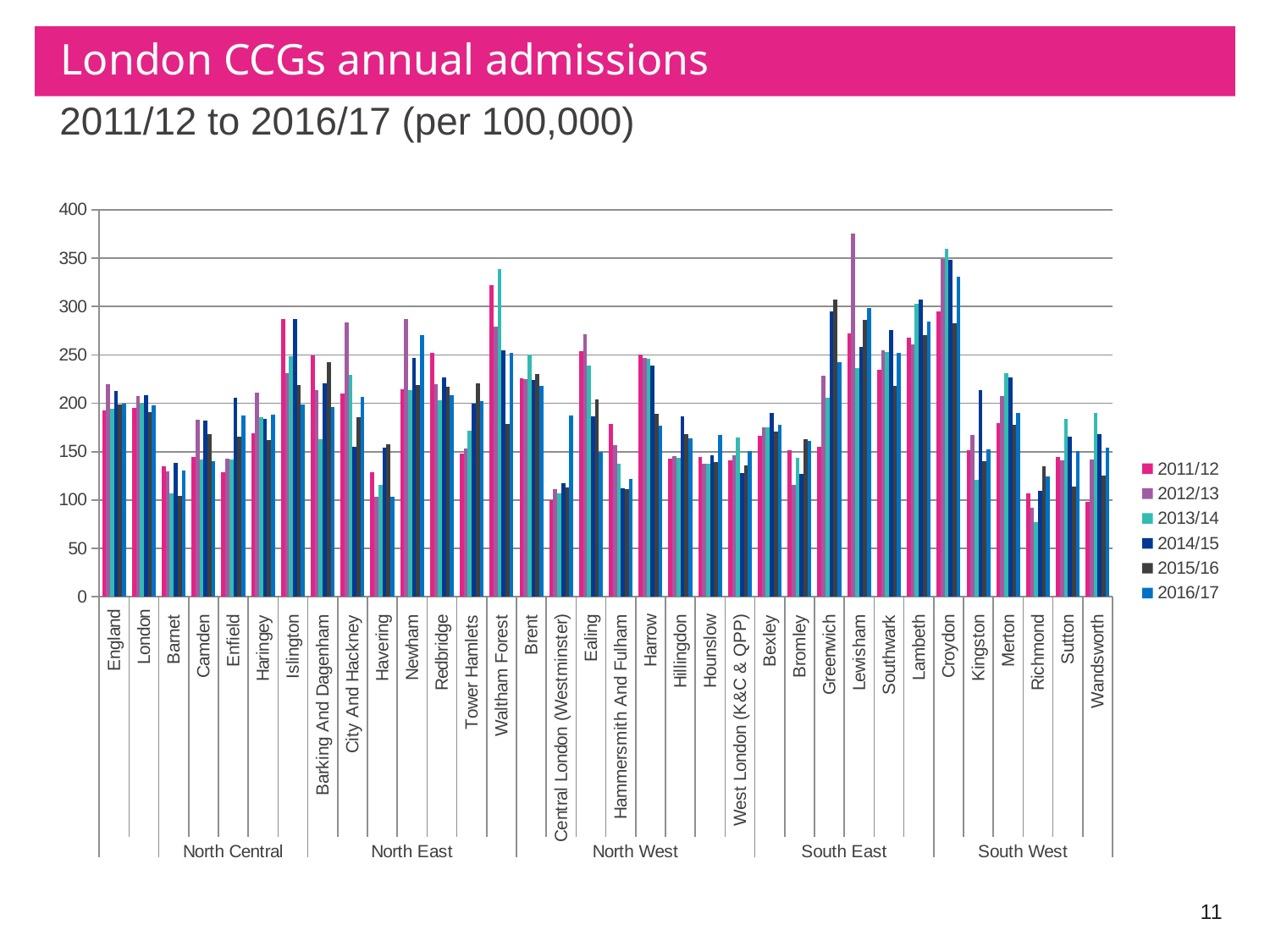
Is the 2011/12 value for Havering greater or less than 150? less How many CCG/area categories are plotted along the x axis? 34 Is the 2012/13 value for Lewisham greater or less than 350? greater How many series does the legend list? 6 Which is larger, the 2011/12 value for Richmond or the 2011/12 value for Sutton? Sutton Which is larger, the 2012/13 value for Lewisham or the 2012/13 value for Croydon? Lewisham Which category contains the tallest bar on the chart? Lewisham Is the 2014/15 value for Kingston greater or less than 200? greater What kind of chart is shown on the slide? bar chart How many regional groupings are labelled beneath the x axis? 5